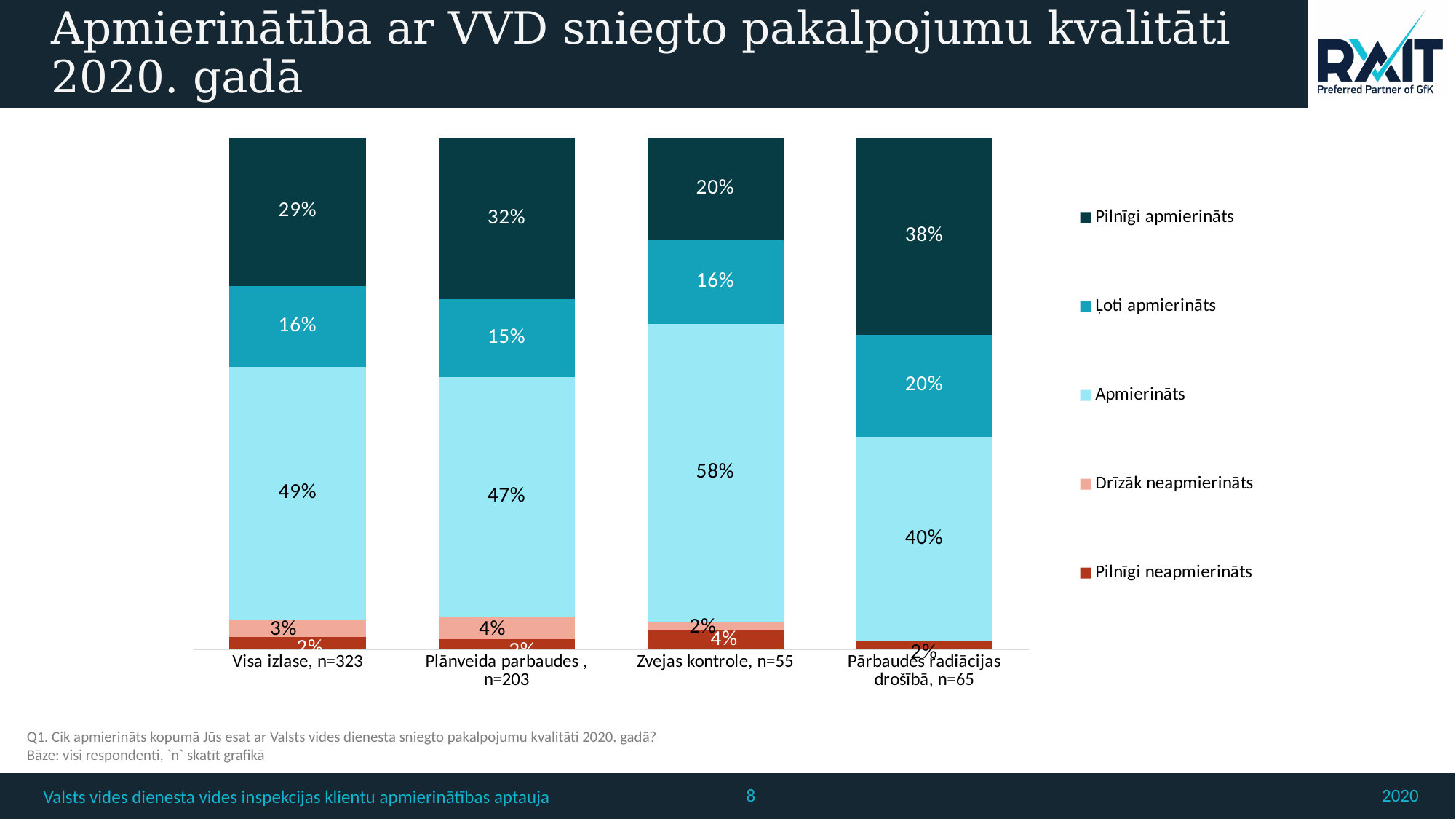
What kind of chart is shown on the slide? Stacked bar chart What is the 'Pilnīgi apmierināts' value for 'Pārbaudes radiācijas drošībā, n=65'? 38% What is the 'Apmierināts' value for 'Zvejas kontrole, n=55'? 58% Which has a larger 'Pilnīgi apmierināts' share: 'Visa izlase, n=323' or 'Plānveida parbaudes , n=203'? Plānveida parbaudes , n=203 Which series is listed first (at the top) in the chart's legend? Pilnīgi apmierināts How many categories (bars) are shown on the x axis of the chart? 4 What is the 'Drīzāk neapmierināts' value for 'Plānveida parbaudes , n=203'? 4% What is the difference in the 'Apmierināts' share between 'Zvejas kontrole, n=55' and 'Pārbaudes radiācijas drošībā, n=65'? 18 percentage points What is the 'Ļoti apmierināts' value for 'Pārbaudes radiācijas drošībā, n=65'? 20% Which category has the highest 'Pilnīgi apmierināts' share? Pārbaudes radiācijas drošībā, n=65 Which category has the lowest 'Pilnīgi apmierināts' share? Zvejas kontrole, n=55 How many series does the chart's legend list? 5